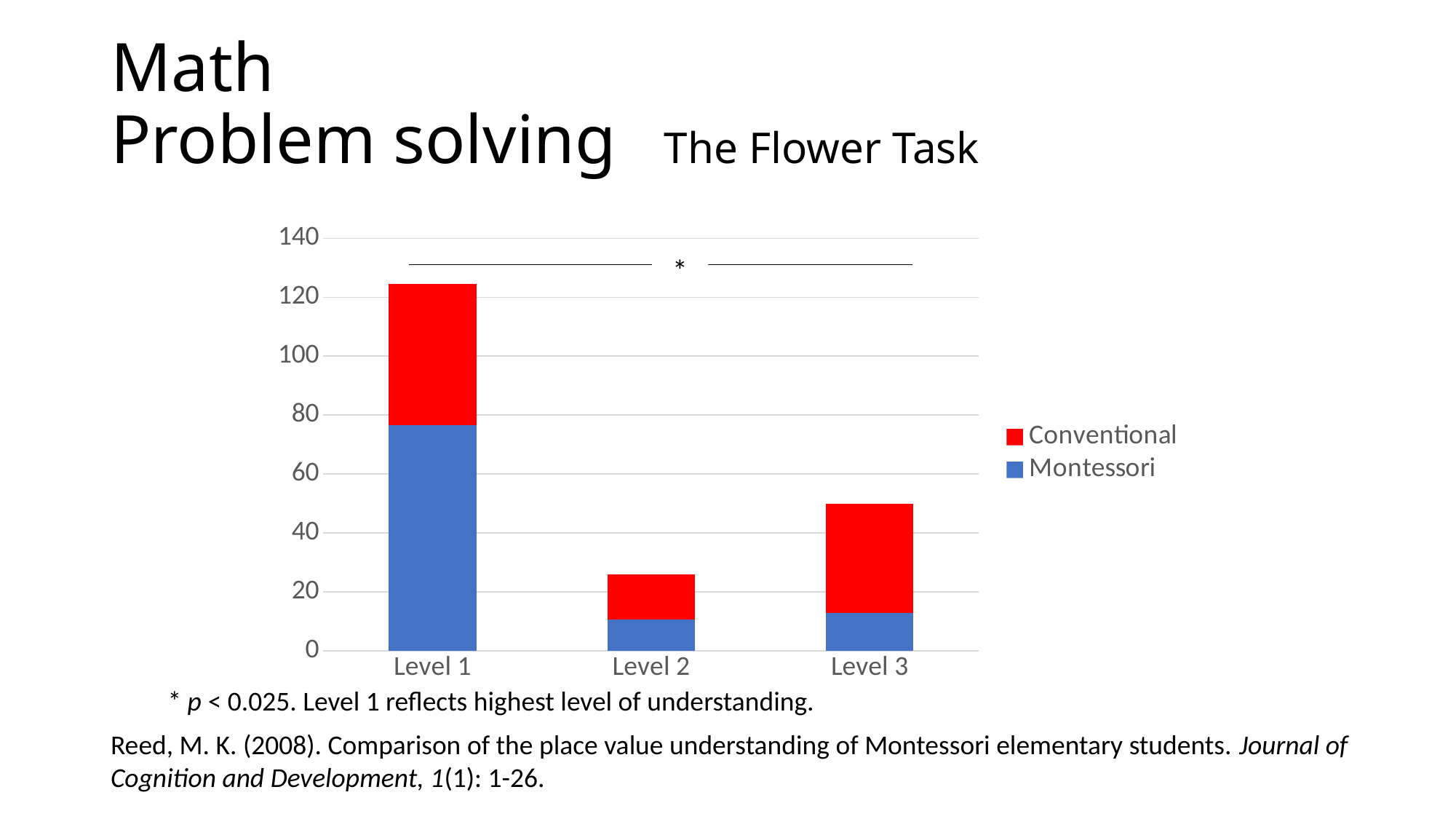
Which series is shown in blue in the chart? Montessori Is the total stacked value for Level 3 greater or less than 60? less Is the total stacked value for Level 1 greater or less than 120? greater Which level has the tallest stacked bar? Level 1 Which level has the shortest stacked bar? Level 2 How many categories are shown on the x axis of the chart? 3 Is the total stacked value for Level 2 greater or less than 40? less How many series does the chart's legend list? 2 What kind of chart is shown on the slide? stacked bar chart Which is larger, the total stacked bar for Level 3 or for Level 2? Level 3 Which series is shown in red in the chart? Conventional